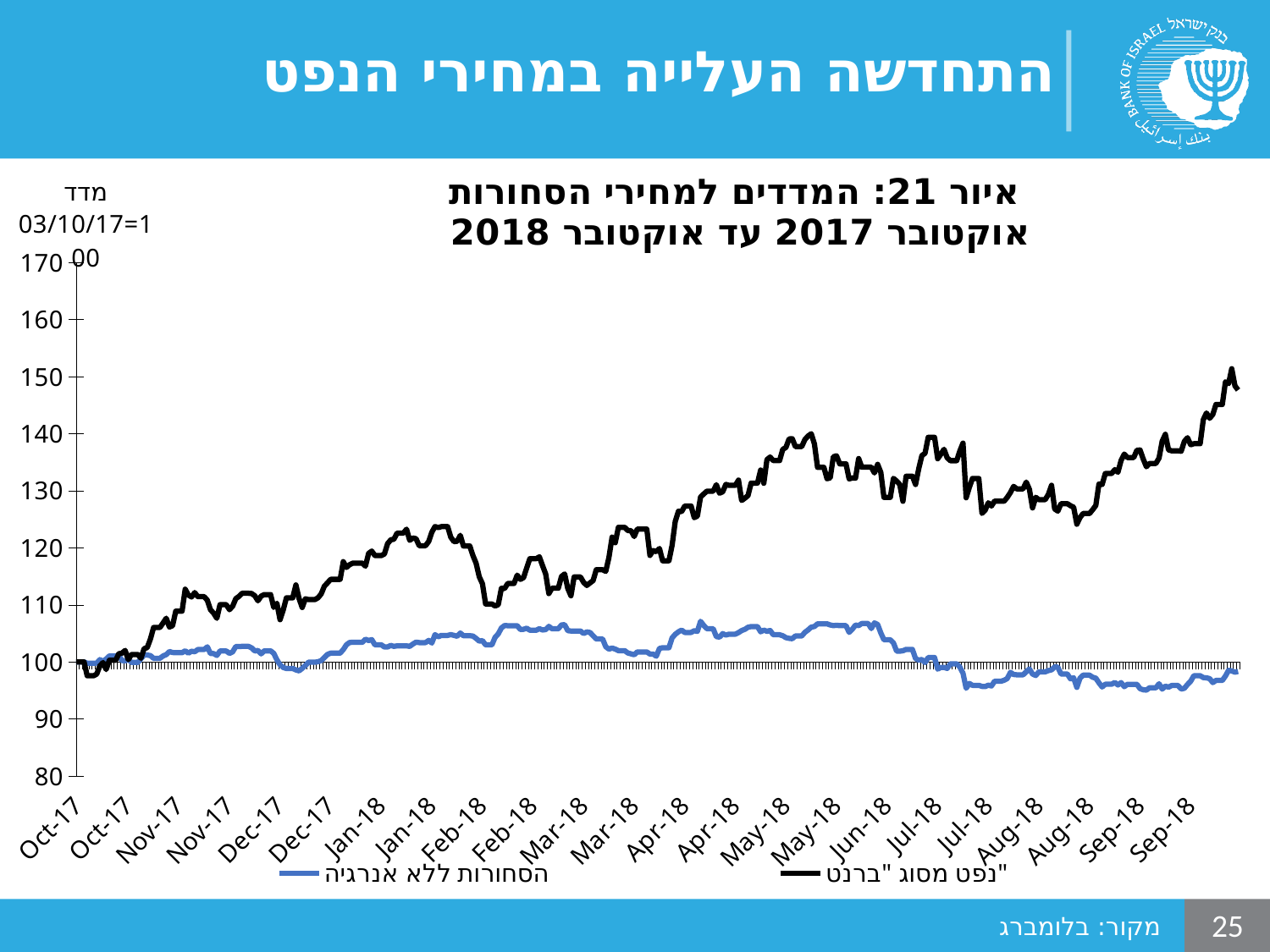
Is the value of the commodities excluding energy (הסחורות ללא אנרגיה) series at the end of Sep-18 greater or less than 110? less Is the value of the Brent oil series in Jul-18 greater or less than 120? greater Which series reaches the highest value on the chart? Brent oil (נפט מסוג "ברנט") Is the value of the commodities excluding energy series in Apr-18 greater or less than 110? less How many series does the legend list? 2 What base date is the index set to, according to the label above the y axis? 03/10/17=1 At Sep-18, which series is higher: Brent oil or commodities excluding energy? Brent oil (נפט מסוג "ברנט") What is the title of the chart? איור 21: המדדים למחירי הסחורות אוקטובר 2017 עד אוקטובר 2018 Does the Brent oil (נפט מסוג "ברנט") series rise or fall overall from Oct-17 to Sep-18? rise What kind of chart is shown on the slide? line chart